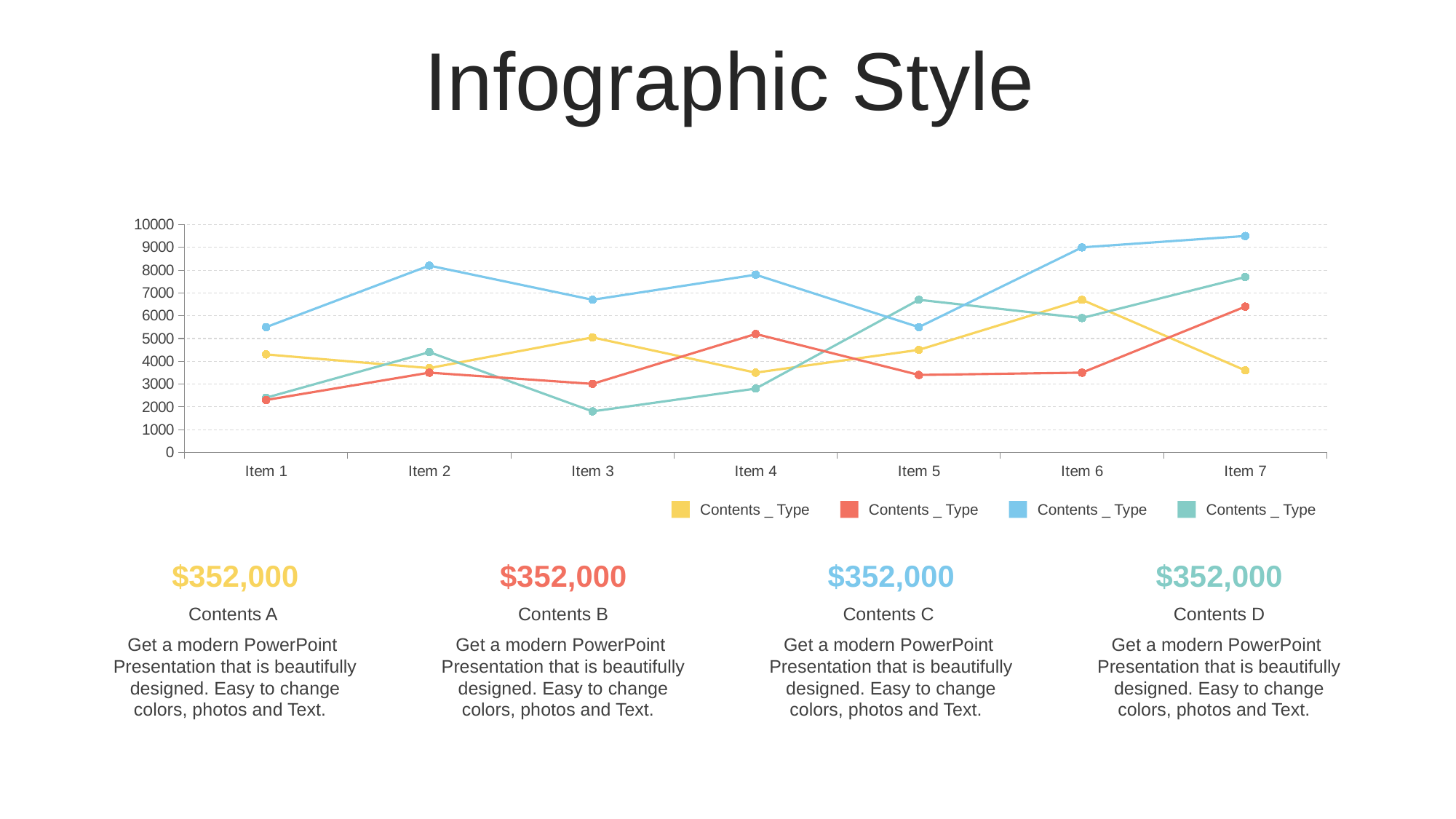
Is the value of the red line at Item 7 greater or less than 6000? greater Is the value of the blue line at Item 7 greater or less than 9000? greater What kind of chart is shown on the slide? Line chart At Item 2, which line has the larger value, the blue line or the red line? Blue line Is the value of the green line at Item 3 greater or less than 2000? less At which item does the blue line reach its highest value? Item 7 How many series does the chart's legend list? 4 Does the blue line rise or fall from Item 5 to Item 7? Rise At which item does the yellow line reach its highest value? Item 6 At which item does the green line reach its lowest value? Item 3 How many items (categories) are plotted along the x axis of the chart? 7